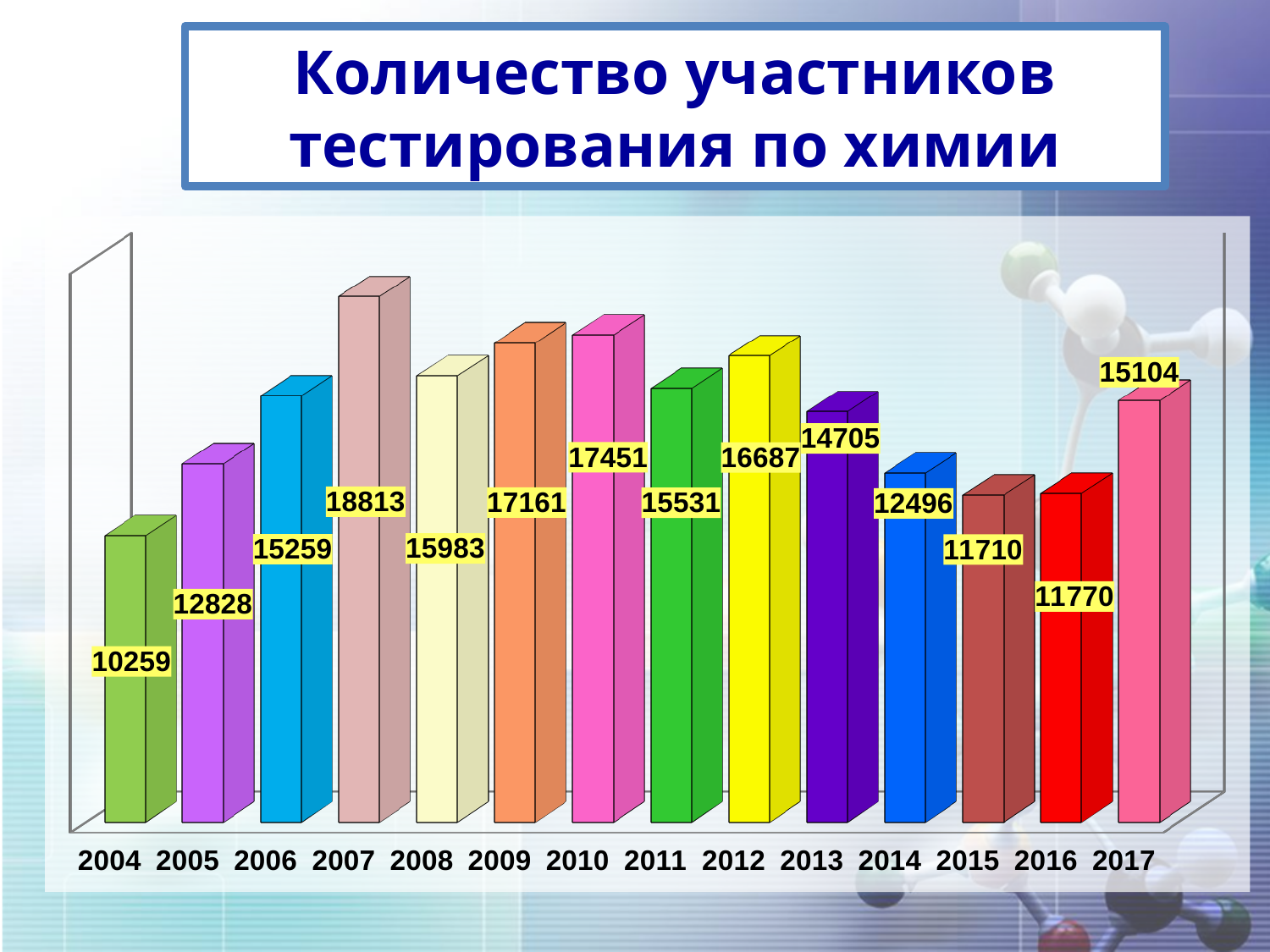
Which year has the highest value? 2007 What is the value for 2013? 14705 What is the difference between the values for 2010 and 2009? 290 What is the difference between the values for 2007 and 2004? 8554 What is the value for 2004? 10259 Do the values rise or fall from 2010 to 2015? fall Which year has the lowest value? 2004 Which is larger, the value for 2012 or the value for 2013? 2012 What is the value for 2007? 18813 What is the value for 2017? 15104 What kind of chart is shown on the slide? bar chart How many years are shown on the x axis? 14